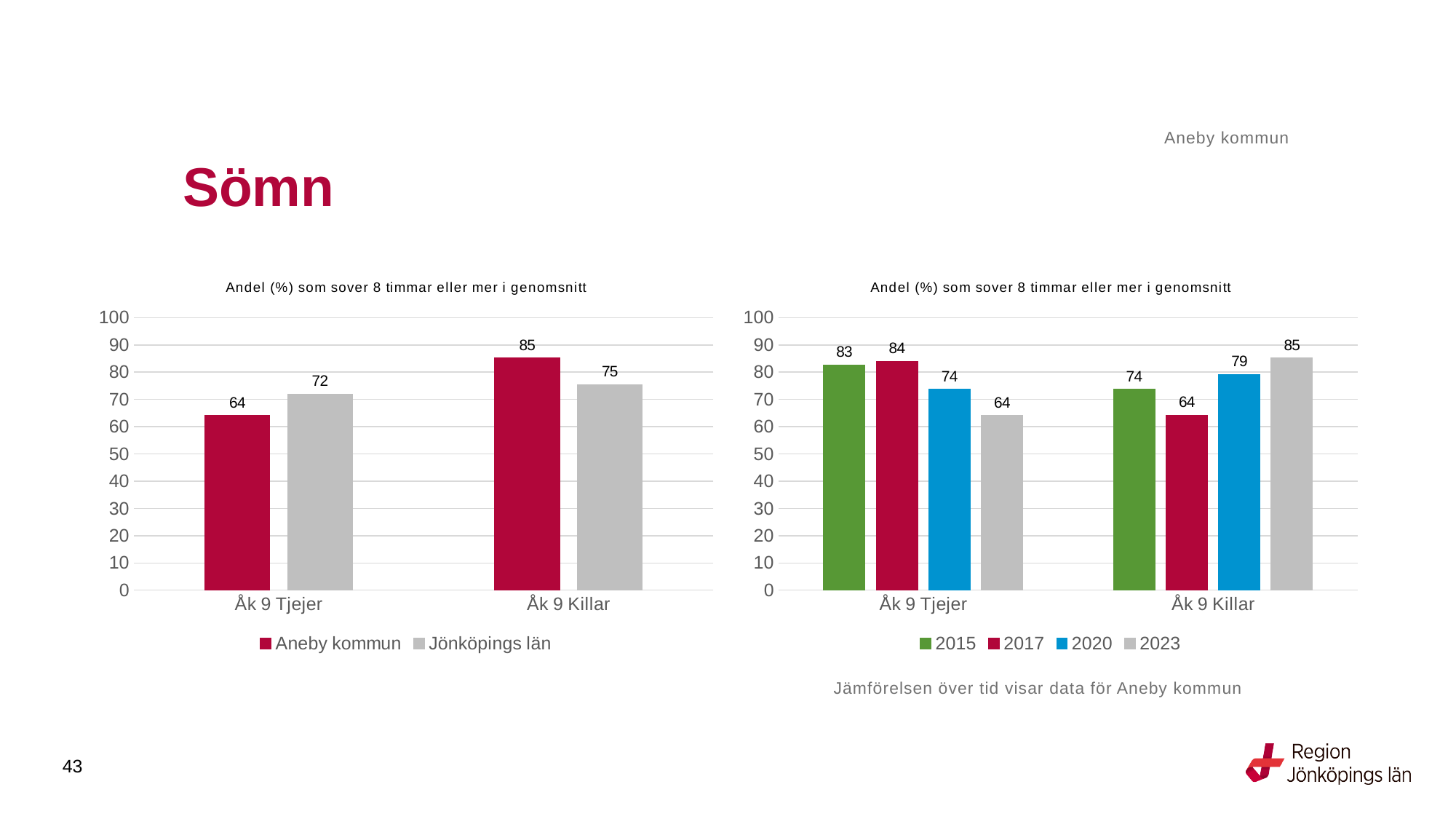
In the right chart, which year has the highest value for Åk 9 Killar? 2023 In the left chart, what is the value for Jönköpings län for Åk 9 Killar? 75 In the left chart, which is larger for Åk 9 Tjejer: Aneby kommun or Jönköpings län? Jönköpings län In the left chart, what is the value for Aneby kommun for Åk 9 Tjejer? 64 In the left chart, how many series does the legend list? 2 In the right chart, which year has the lowest value for Åk 9 Tjejer? 2023 In the right chart, how many series does the legend list? 4 In the left chart, what is the difference between Aneby kommun and Jönköpings län for Åk 9 Killar? 10 In the right chart, what is the value for 2023 for Åk 9 Tjejer? 64 What kind of chart is the left chart? Bar chart In the right chart, what is the difference between 2015 and 2023 for Åk 9 Tjejer? 19 In the right chart, what is the value for 2020 for Åk 9 Killar? 79